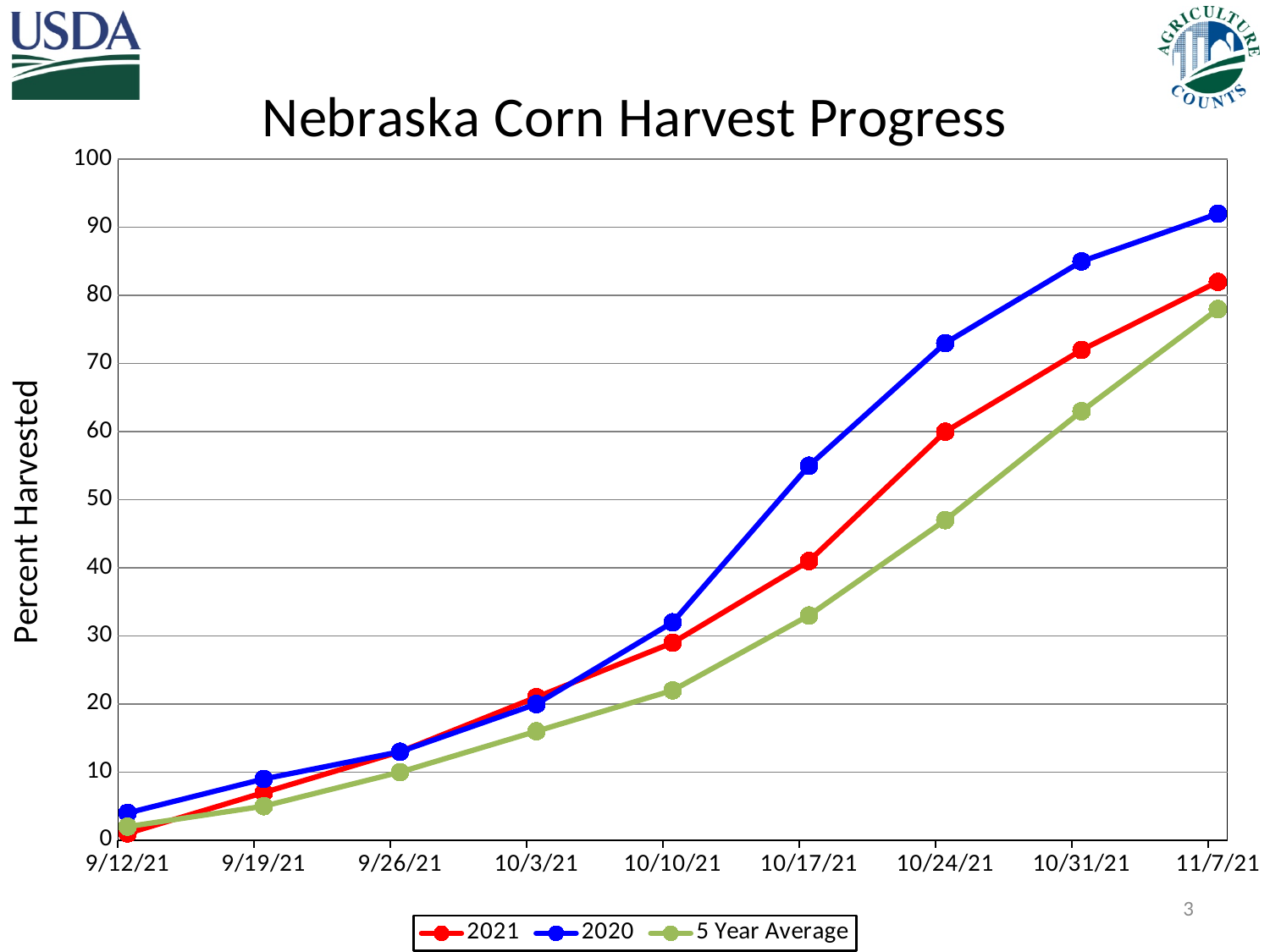
Which series has the lowest value on 10/24/21? 5 Year Average How many series does the legend list? 3 What kind of chart is shown on the slide? line chart Is the value for 5 Year Average on 10/24/21 greater or less than 50? less How many dates are plotted along the x axis? 9 Do the values for 2021 rise or fall from 9/12/21 to 11/7/21? rise What is the title of the chart? Nebraska Corn Harvest Progress Is the value for 2021 on 10/24/21 greater or less than 50? greater On 10/17/21, which is larger: the value for 2020 or the value for 5 Year Average? 2020 Is the value for 2020 on 11/7/21 greater or less than 80? greater Which series has the highest value on 11/7/21? 2020 What is the label on the y axis? Percent Harvested